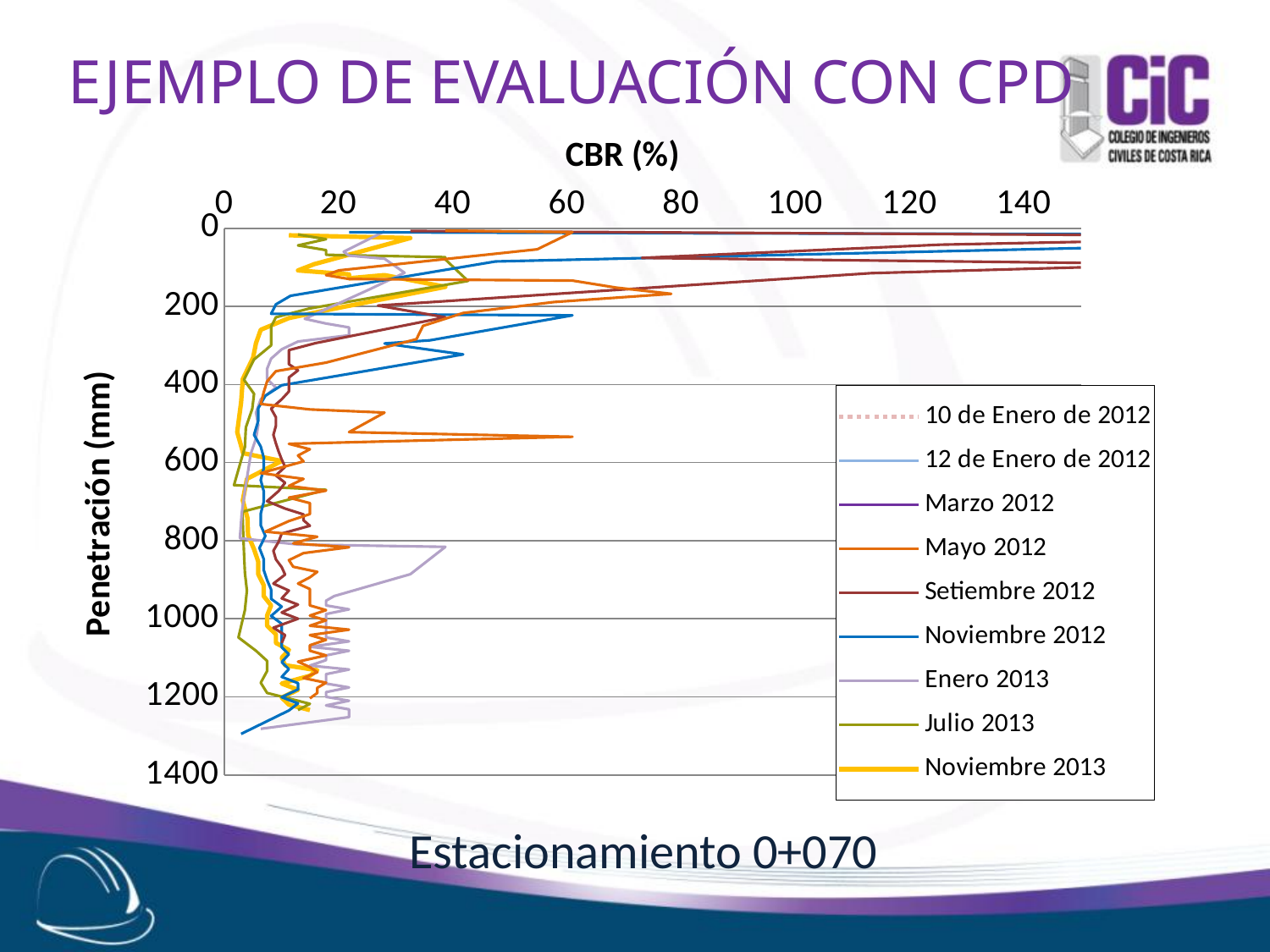
Is the maximum CBR value reached by the Enero 2013 series greater or less than 60? less Do the CBR values generally decrease or increase as penetration increases? Decrease What is the title of the horizontal axis of the chart? CBR (%) Which series is listed first in the legend? 10 de Enero de 2012 How many series does the legend list? 9 Is the maximum CBR value reached by the Setiembre 2012 series greater or less than 140? greater Which series reaches a higher maximum CBR value, Setiembre 2012 or Noviembre 2013? Setiembre 2012 Which series reaches a higher maximum CBR value, Mayo 2012 or Julio 2013? Mayo 2012 Is the maximum CBR value reached by the Julio 2013 series greater or less than 60? less What kind of chart is shown on the slide? Line chart